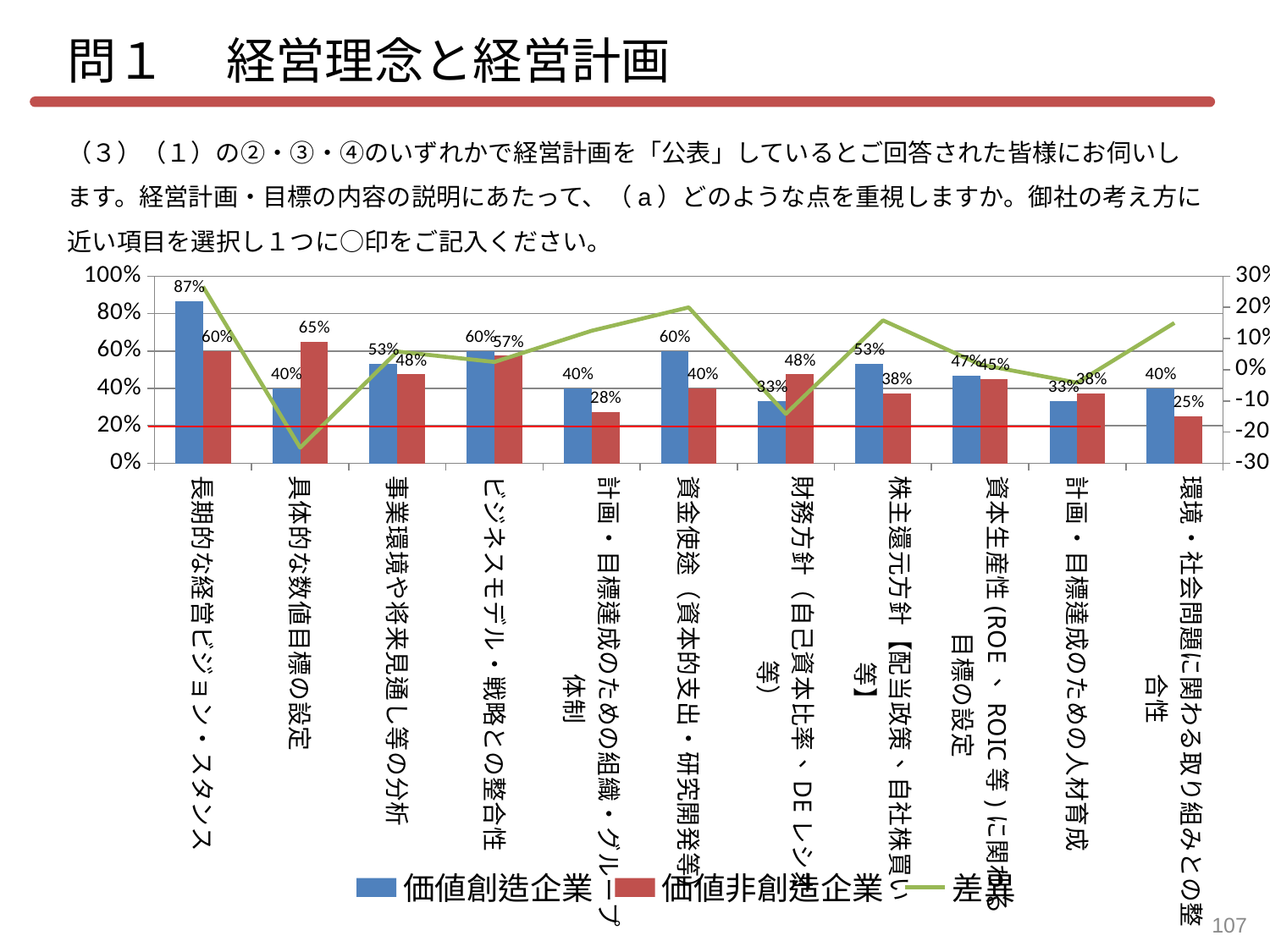
How many series does the chart legend list? 3 What is the value for 価値創造企業 in the 長期的な経営ビジョン・スタンス category? 87% What kind of chart is shown on the slide? Bar chart with a line series What is the value for 価値非創造企業 in the 具体的な数値目標の設定 category? 65% What is the difference between 価値創造企業 and 価値非創造企業 in the 長期的な経営ビジョン・スタンス category? 27 percentage points What is the value for 価値非創造企業 in the 計画・目標達成のための組織・グループ体制 category? 28% Which category has the lowest value for 価値非創造企業? 環境・社会問題に関わる取り組みとの整合性 In the 財務方針（自己資本比率、DEレシオ等） category, which is larger: 価値創造企業 or 価値非創造企業? 価値非創造企業 Is the 差異 line value for 長期的な経営ビジョン・スタンス greater or less than 20 on the right axis? greater How many categories are shown on the x axis of the chart? 11 Which colour represents 価値非創造企業 in the chart? Red Which category has the highest value for 価値創造企業? 長期的な経営ビジョン・スタンス